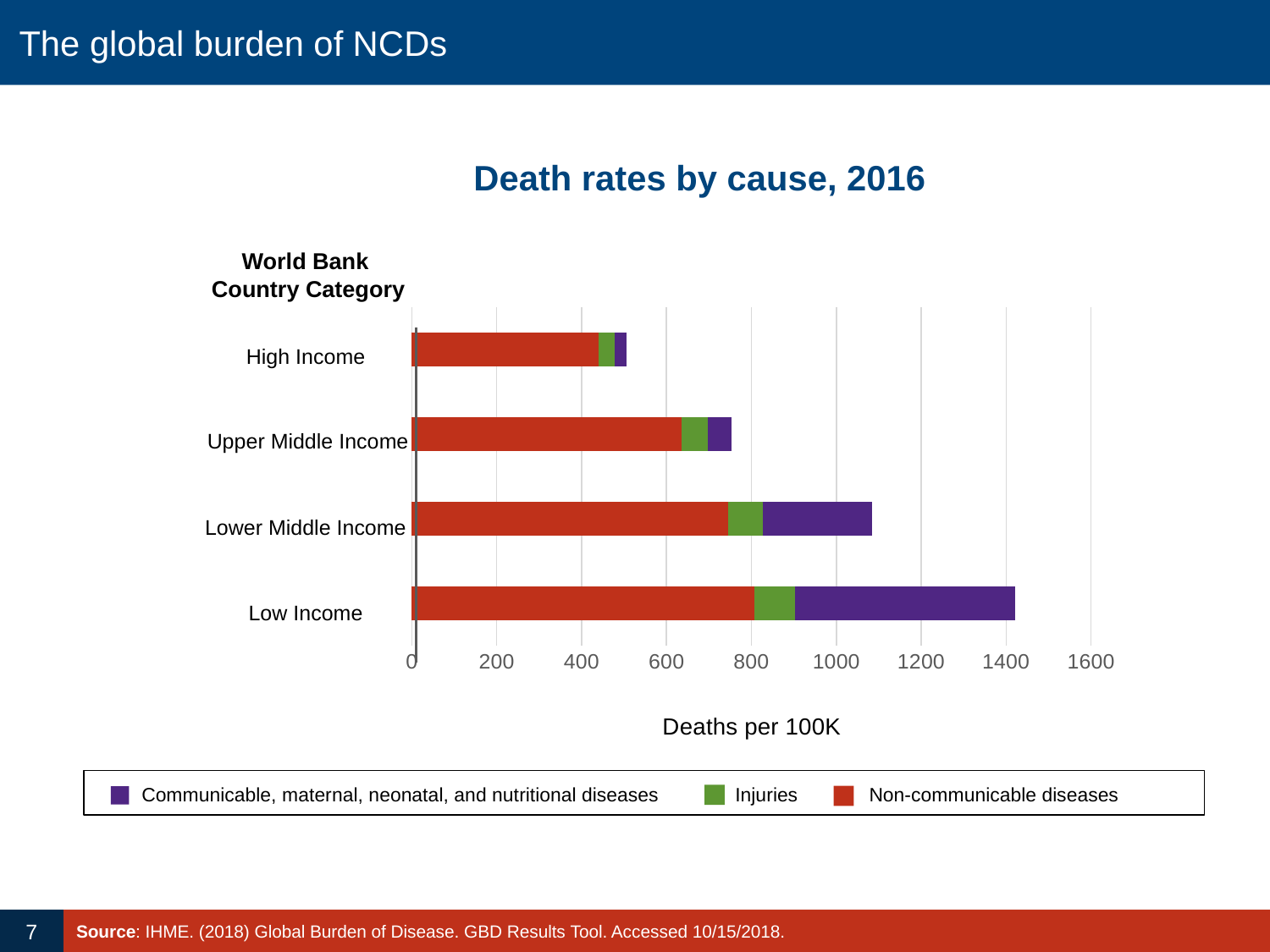
Which country category has the highest total death rate? Low Income How many World Bank country categories are plotted on the chart? 4 What kind of chart is shown on the slide? Stacked bar chart Is the total death rate for Lower Middle Income greater or less than 1000? greater Is the total death rate for Low Income greater or less than 1200? greater Which country category has the lowest total death rate? High Income Is the total death rate for High Income greater or less than 600? less Which has a larger total death rate, Lower Middle Income or Upper Middle Income? Lower Middle Income What is the title of the chart? Death rates by cause, 2016 What is the label on the horizontal axis of the chart? Deaths per 100K How many series does the legend list? 3